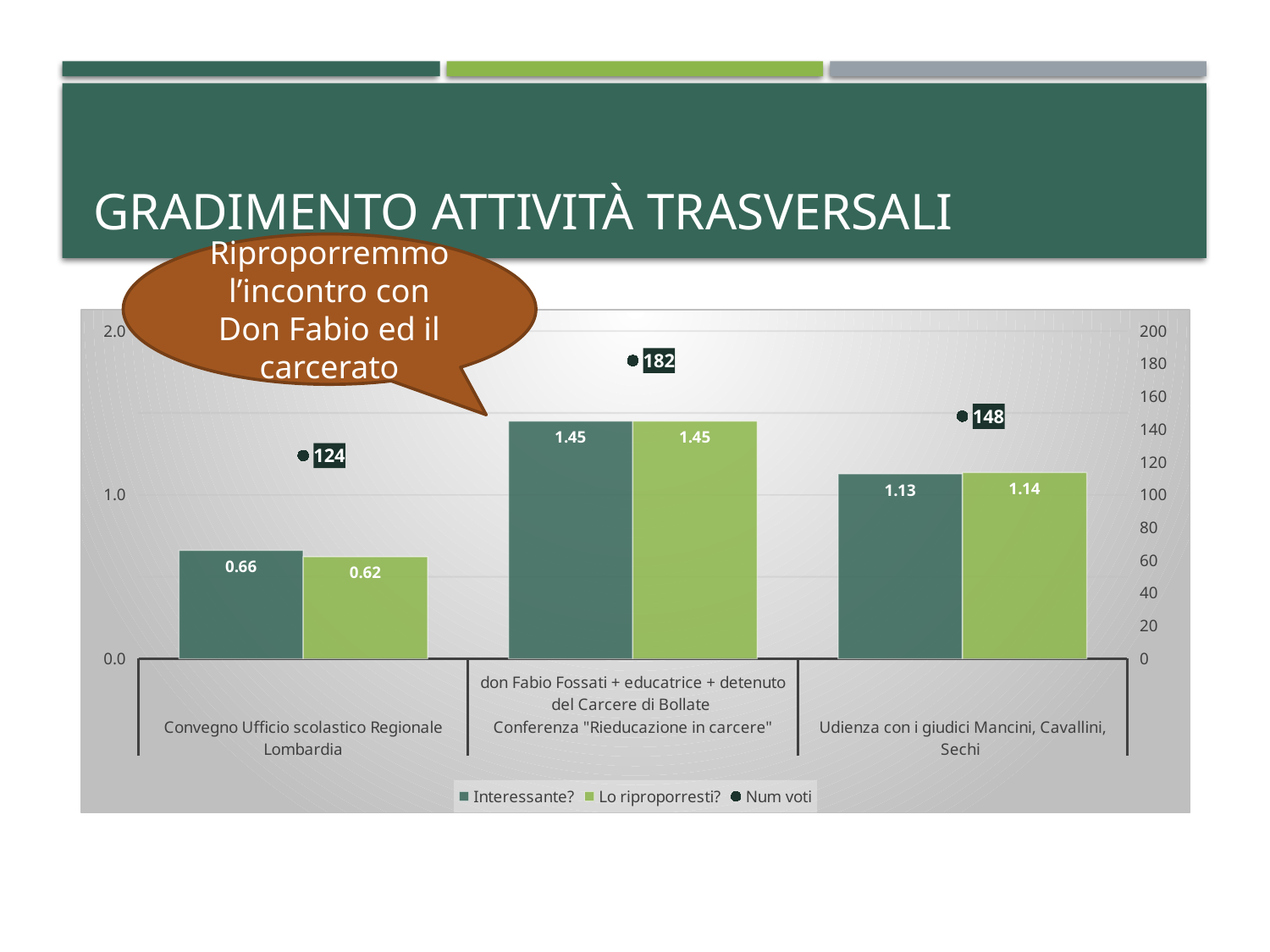
What is the title of the slide containing the chart? GRADIMENTO ATTIVITÀ TRASVERSALI Which category has the lowest "Interessante?" value? Convegno Ufficio scolastico Regionale Lombardia What is the difference between the "Num voti" values for the don Fabio Fossati conference and the Convegno Ufficio scolastico Regionale Lombardia? 58 What is the "Interessante?" value for "Convegno Ufficio scolastico Regionale Lombardia"? 0.66 What kind of chart is shown on the slide? Bar chart with a point series How many series does the legend list? 3 What is the "Num voti" value for the "don Fabio Fossati + educatrice + detenuto del Carcere di Bollate Conferenza "Rieducazione in carcere"" category? 182 What is the "Num voti" value for "Udienza con i giudici Mancini, Cavallini, Sechi"? 148 Which category has the highest "Num voti" value? don Fabio Fossati + educatrice + detenuto del Carcere di Bollate Conferenza "Rieducazione in carcere" What is the "Lo riproporresti?" value for "Udienza con i giudici Mancini, Cavallini, Sechi"? 1.14 Which is larger: the "Interessante?" value for "Udienza con i giudici Mancini, Cavallini, Sechi" or for "Convegno Ufficio scolastico Regionale Lombardia"? Udienza con i giudici Mancini, Cavallini, Sechi How many categories are shown on the x axis? 3